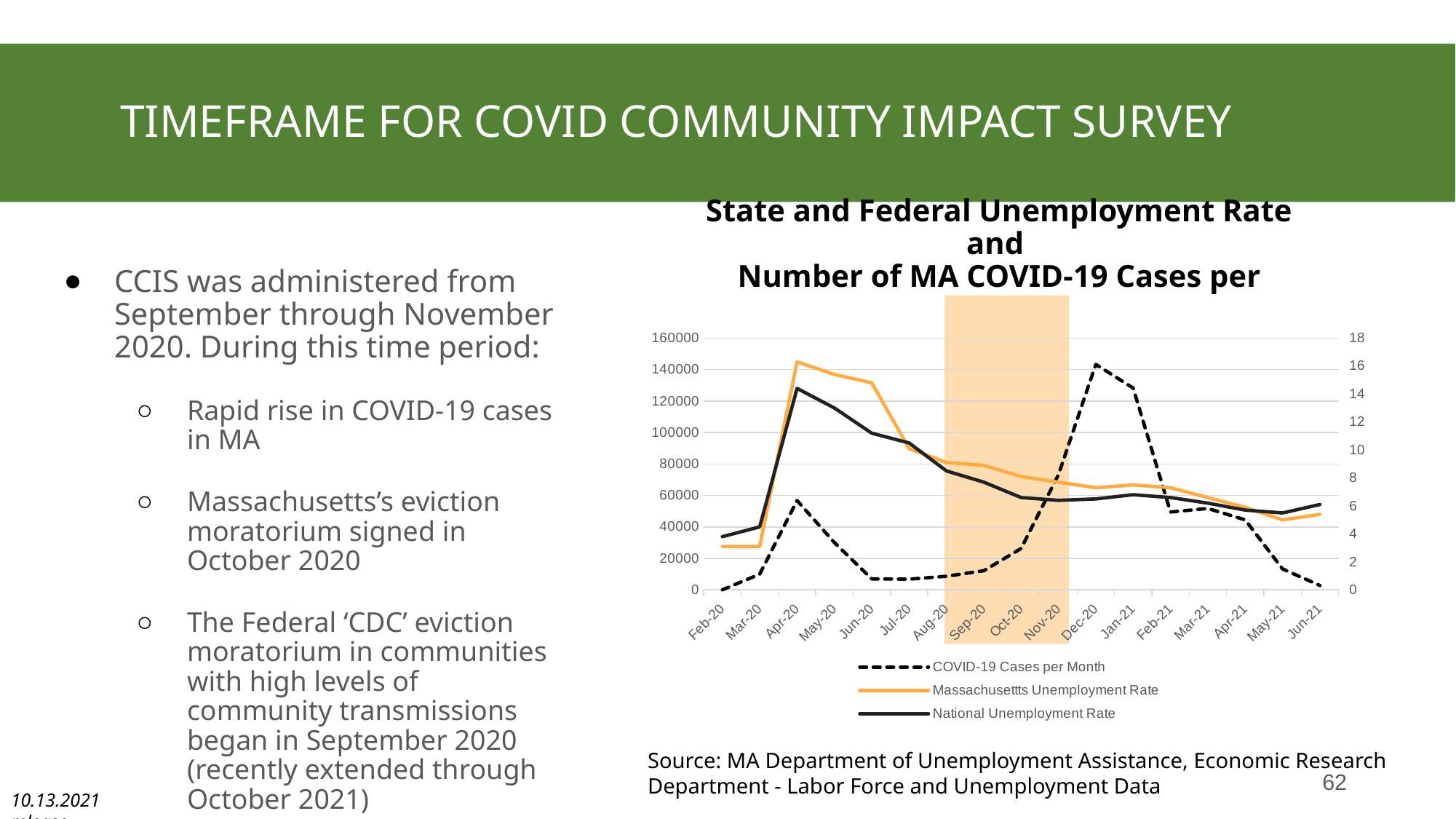
Do COVID-19 Cases per Month rise or fall between Jun-20 and Dec-20? Rise On the right-hand axis, is the Massachusetts Unemployment Rate in Apr-20 greater or less than 14? greater Is the value for COVID-19 Cases per Month in Dec-20 greater or less than 120000? greater How many series does the legend list? 3 How many months are shown along the x axis? 17 Which series is drawn with a dashed line? COVID-19 Cases per Month Which months are covered by the shaded orange band on the chart? Sep-20 to Nov-20 What kind of chart is shown on the slide? Line chart In which month do COVID-19 Cases per Month reach their highest value? Dec-20 In which month is the Massachusetts Unemployment Rate at its highest? Apr-20 Is the value for COVID-19 Cases per Month in Jun-20 greater or less than 20000? less In Apr-20, which is higher: the Massachusetts Unemployment Rate or the National Unemployment Rate? Massachusetts Unemployment Rate